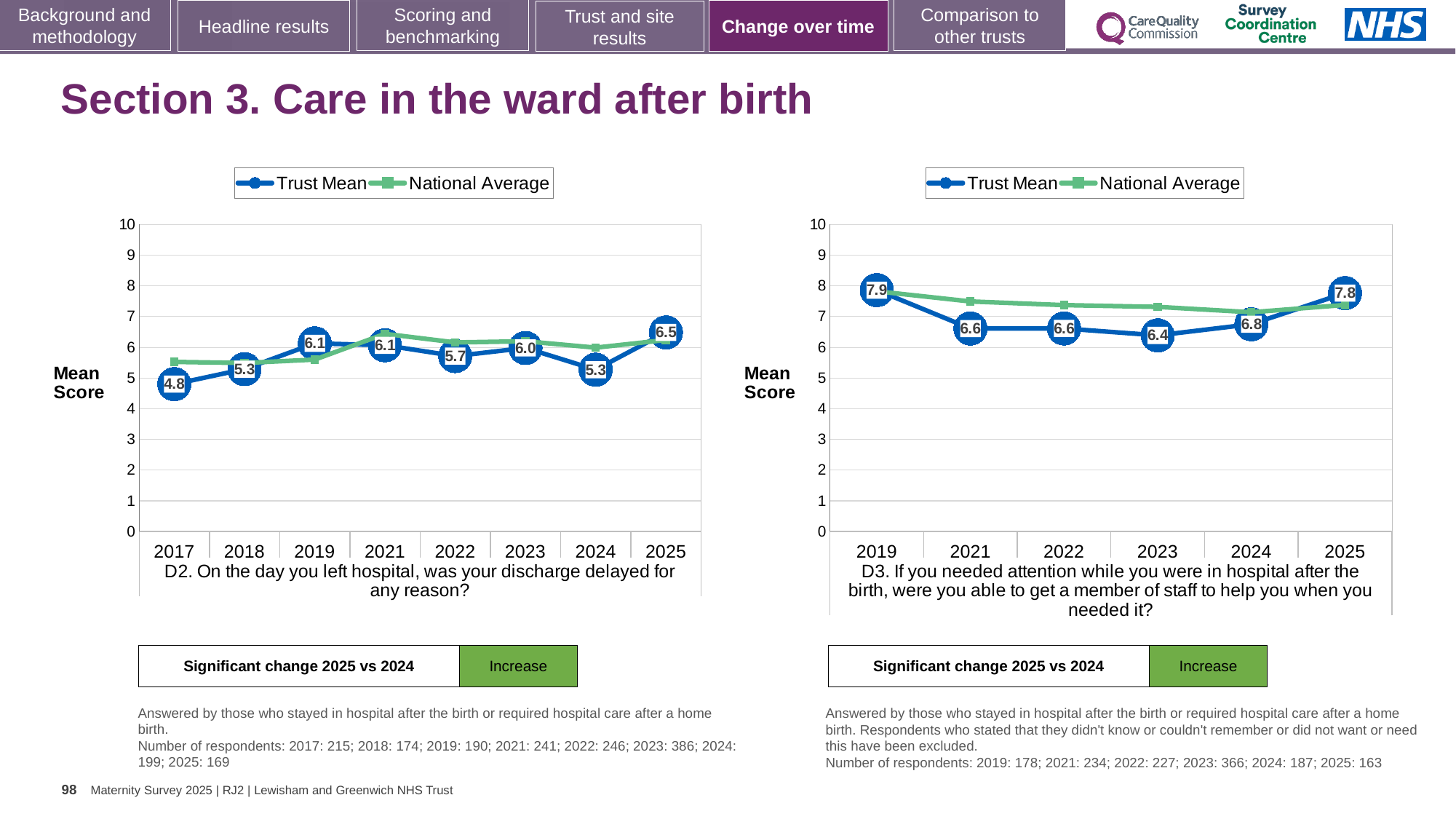
In the left chart (D2), what is the Trust Mean score for 2025? 6.5 In the right chart (D3), is the National Average value for 2019 greater or less than 7? greater In the left chart (D2), how many years are shown on the x axis? 8 In the left chart (D2), which year has the lowest Trust Mean score? 2017 What type of chart is the left chart (D2)? Line chart In the right chart (D3), which year has the lowest Trust Mean score? 2023 In the right chart (D3), is the Trust Mean score for 2025 greater or less than the score for 2024? greater How many series does the legend of the right chart (D3) list? 2 In the left chart (D2), what is the Trust Mean score for 2017? 4.8 In the left chart (D2), which year has the highest Trust Mean score? 2025 In the right chart (D3), what is the Trust Mean score for 2019? 7.9 In the left chart (D2), what is the difference between the Trust Mean scores for 2025 and 2024? 1.2